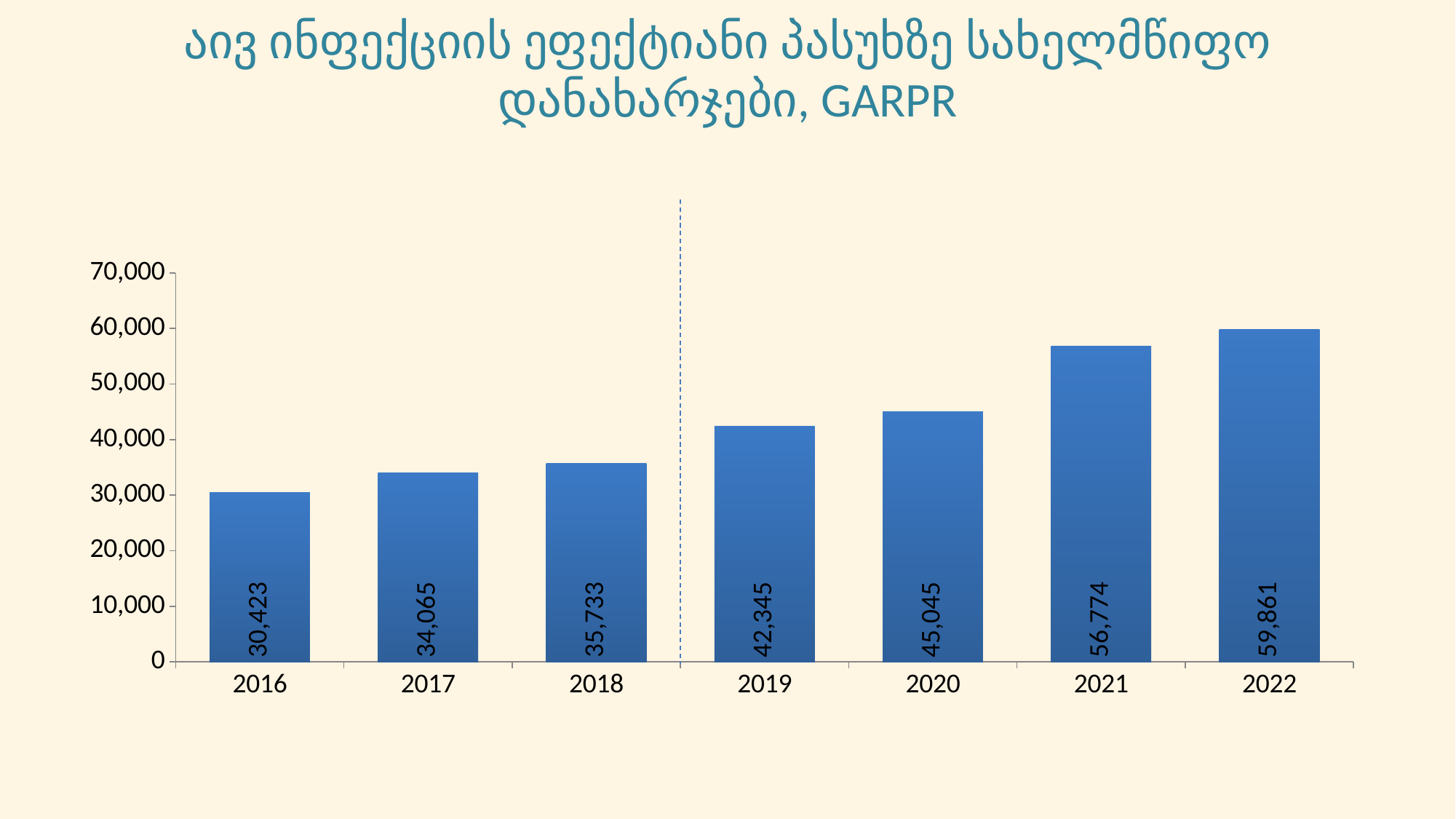
What is the value for 2022? 59,861 Is the value for 2021 greater or less than 50,000? greater What is the difference between the values for 2022 and 2016? 29,438 What is the value for 2019? 42,345 Which is larger, the value for 2018 or the value for 2019? 2019 Which year has the lowest value? 2016 How many years are shown on the x axis? 7 Do the values rise or fall from 2016 to 2022? rise What is the difference between the values for 2021 and 2020? 11,729 Which year has the highest value? 2022 What kind of chart is shown on the slide? bar chart What is the value for 2016? 30,423